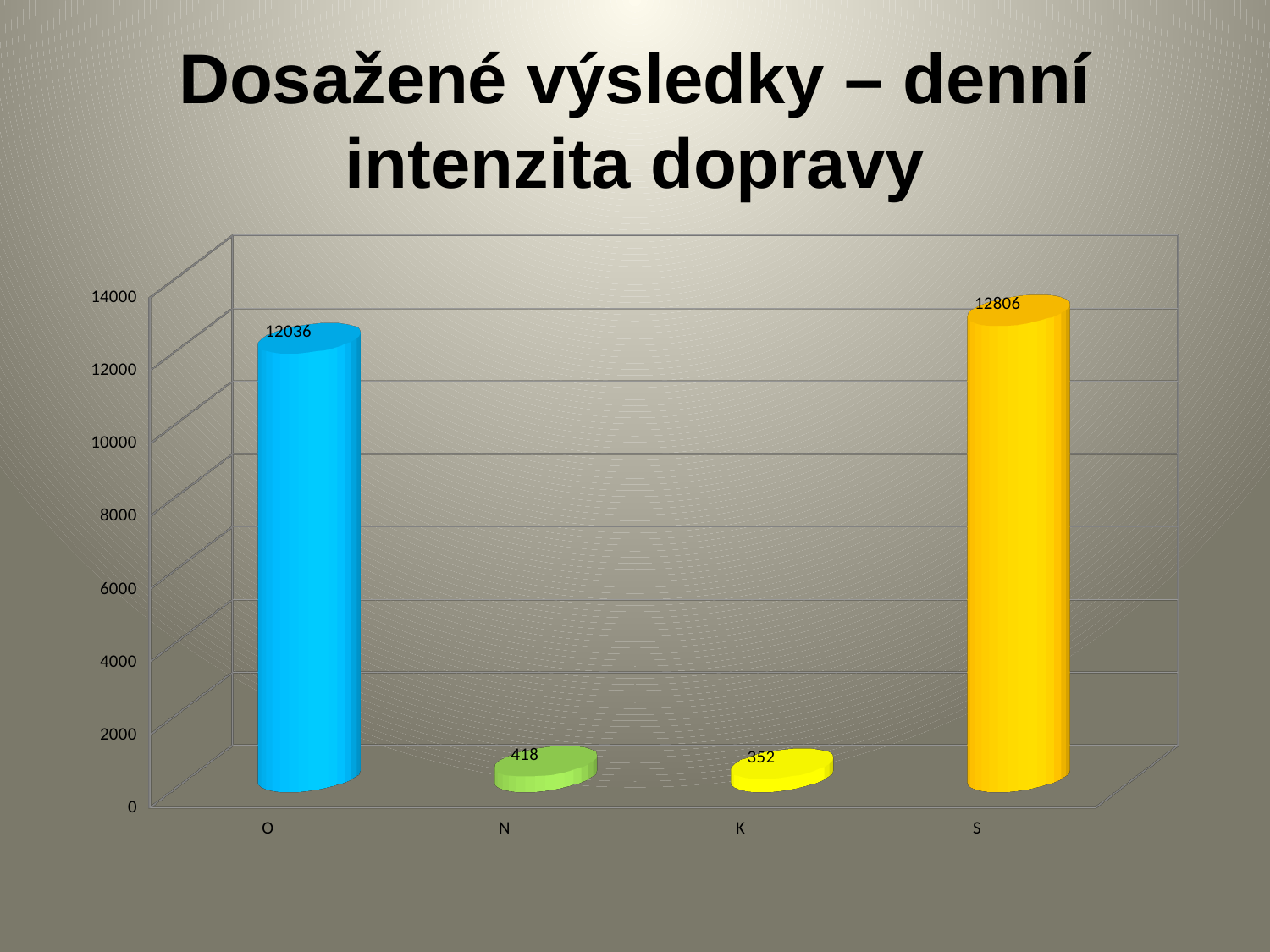
Which is larger, the value for O or the value for S? S What is the value for category K? 352 What is the value for category N? 418 What is the value for category O? 12036 What is the difference between the values for S and O? 770 How many categories are shown on the x axis? 4 What is the difference between the values for N and K? 66 Which category has the highest value? S What is the value for category S? 12806 Is the value for O greater or less than 10000? greater Which category has the lowest value? K What kind of chart is shown on the slide? bar chart